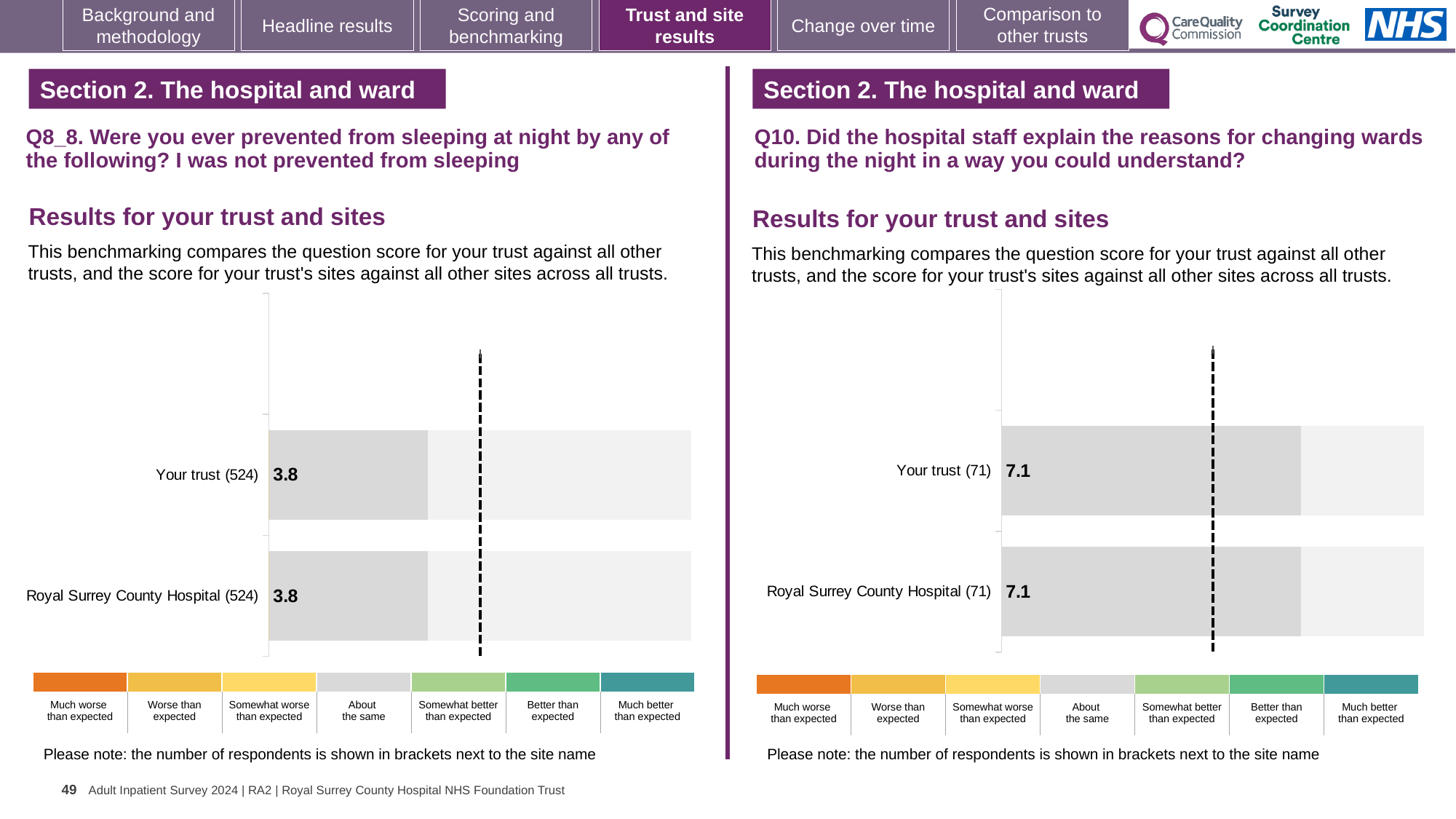
In the Q10 chart on the right, what is the score for Royal Surrey County Hospital? 7.1 In the Q8_8 chart on the left, what is the difference between the score for Your trust and the score for Royal Surrey County Hospital? 0.0 In the Q10 chart on the right, what is the difference between the score for Your trust and the score for Royal Surrey County Hospital? 0.0 In the Q8_8 chart on the left, which benchmark category does the grey colour of the bars correspond to in the legend? About the same In the Q10 chart on the right, how many respondents are shown in brackets for Royal Surrey County Hospital? 71 What kind of chart is used for the Q10 results on the right? Bar chart In the Q8_8 chart on the left, how many respondents are shown in brackets for Your trust? 524 In the Q8_8 chart on the left, what is the score for Your trust? 3.8 In the Q10 chart on the right, what is the score for Your trust? 7.1 In the Q8_8 chart on the left, what is the score for Royal Surrey County Hospital? 3.8 How many bars are plotted in the Q8_8 chart on the left? 2 How many bars are plotted in the Q10 chart on the right? 2